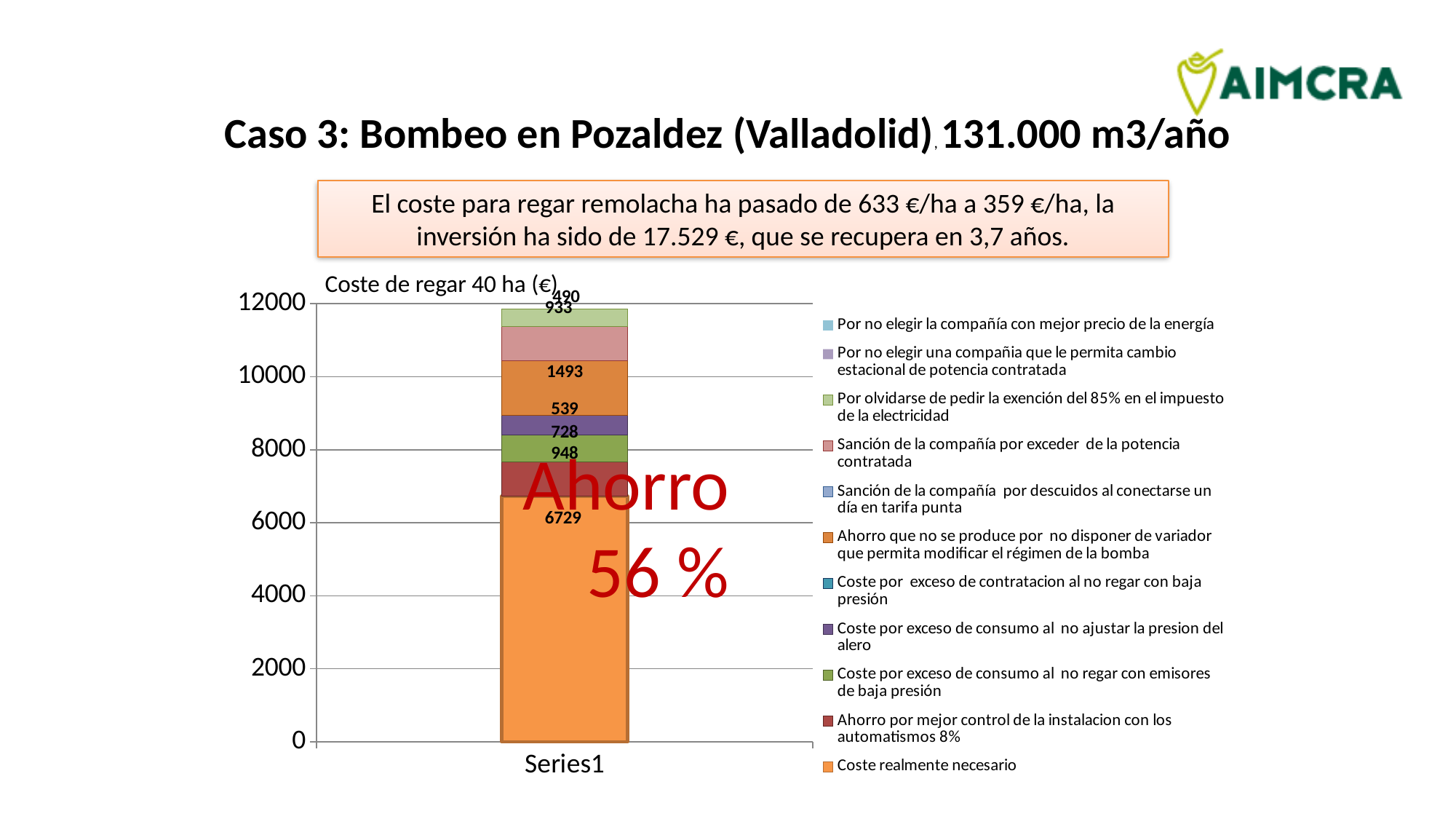
What kind of chart is shown on the slide? stacked bar chart What is the total of all the data labels on the stacked bar? 11860 Which data label on the stacked bar is the smallest? 490 What is the value of the 'Coste realmente necesario' segment at the bottom of the bar? 6729 What is the difference between the largest data label (6729) and the second largest (1493)? 5236 What category label appears under the bar on the x axis? Series1 What is the title of the chart? Coste de regar 40 ha (€) Is the total height of the stacked bar greater or less than 12000? less How many bars (categories) are plotted on the x axis? 1 Which data label on the stacked bar is the largest? 6729 How many entries does the chart legend list? 11 Is the total height of the stacked bar greater or less than 10000? greater